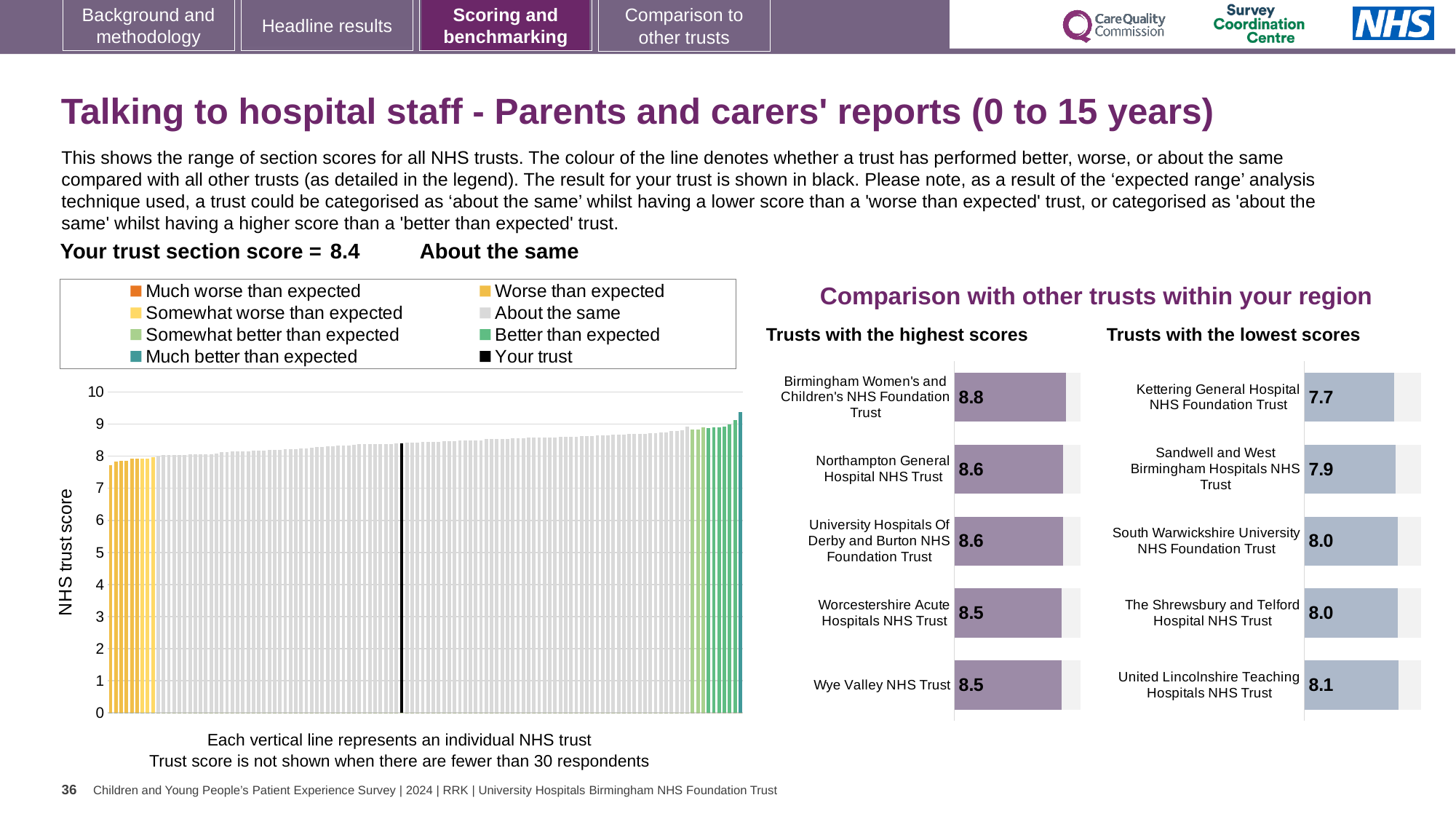
In the NHS trust score chart on the left, is the value of the rightmost bar greater or less than 9? greater In the 'Trusts with the lowest scores' chart, what is the score for Sandwell and West Birmingham Hospitals NHS Trust? 7.9 In the 'Trusts with the lowest scores' chart, which has the larger score: Kettering General Hospital NHS Foundation Trust or United Lincolnshire Teaching Hospitals NHS Trust? United Lincolnshire Teaching Hospitals NHS Trust In the 'Trusts with the highest scores' chart, what is the score for Birmingham Women's and Children's NHS Foundation Trust? 8.8 In the 'Trusts with the lowest scores' chart, what is the score for Kettering General Hospital NHS Foundation Trust? 7.7 In the 'Trusts with the highest scores' chart, which trust has the highest score? Birmingham Women's and Children's NHS Foundation Trust In the 'Trusts with the highest scores' chart, what is the difference between the scores of Birmingham Women's and Children's NHS Foundation Trust and Wye Valley NHS Trust? 0.3 In the NHS trust score chart on the left, what is the section score for your trust (the black line)? 8.4 In the NHS trust score chart on the left, do the values rise or fall from left to right? rise In the 'Trusts with the lowest scores' chart, which trust has the lowest score? Kettering General Hospital NHS Foundation Trust How many trusts are shown in the 'Trusts with the lowest scores' chart? 5 How many entries does the legend of the NHS trust score chart on the left list? 8